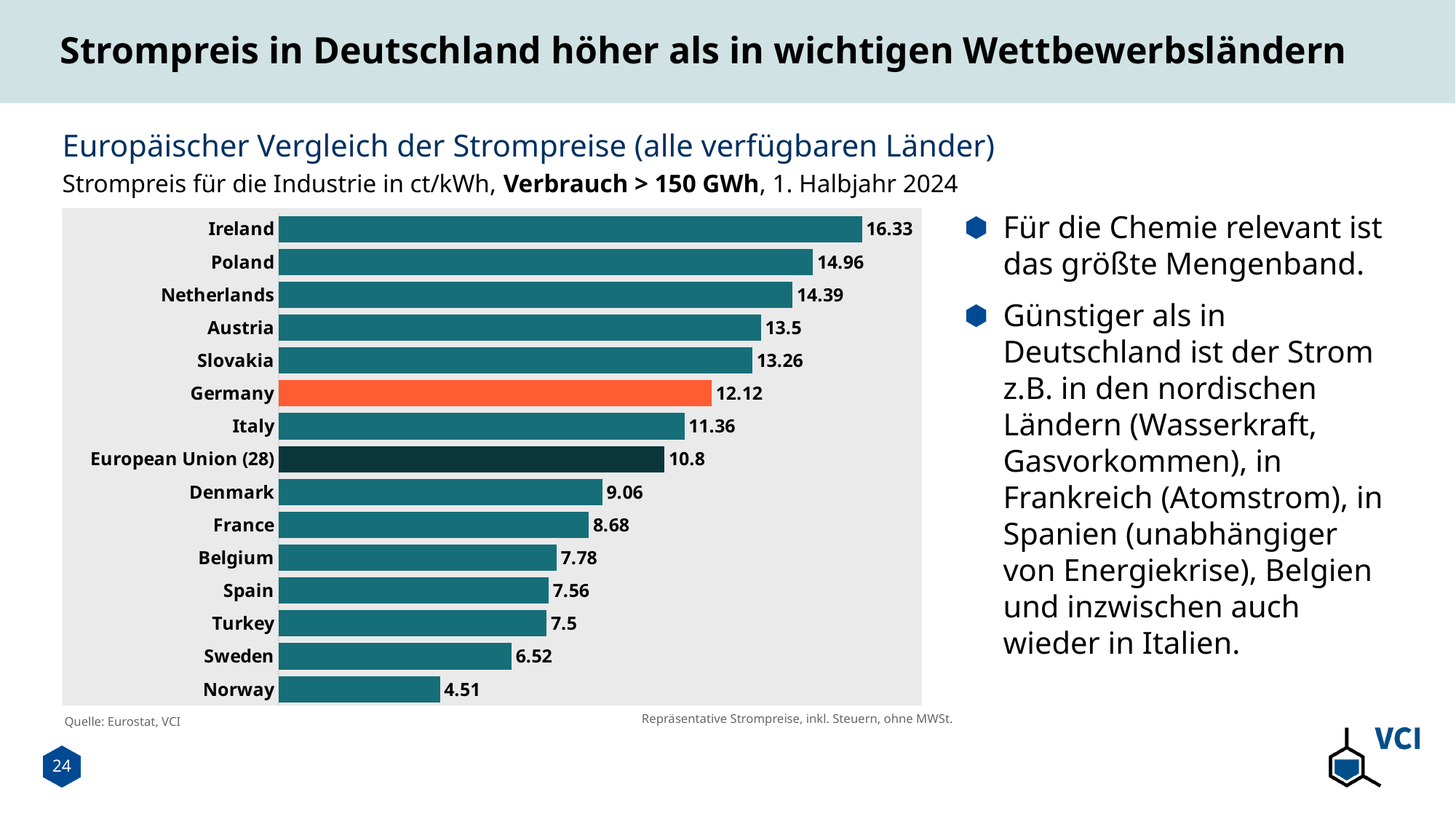
Which country has the lowest electricity price in the chart? Norway Which has a higher value, Poland or Netherlands? Poland What is the difference between the values for Ireland and Norway? 11.82 What is the difference between the values for Germany and European Union (28)? 1.32 What is the value shown for European Union (28)? 10.8 What type of chart is shown on the slide? Bar chart What is the electricity price shown for Germany? 12.12 Which bar in the chart is highlighted in orange? Germany Which country has the highest electricity price in the chart? Ireland What is the value shown for France? 8.68 Which has a higher value, Denmark or Belgium? Denmark How many countries or regions are shown in the chart? 15